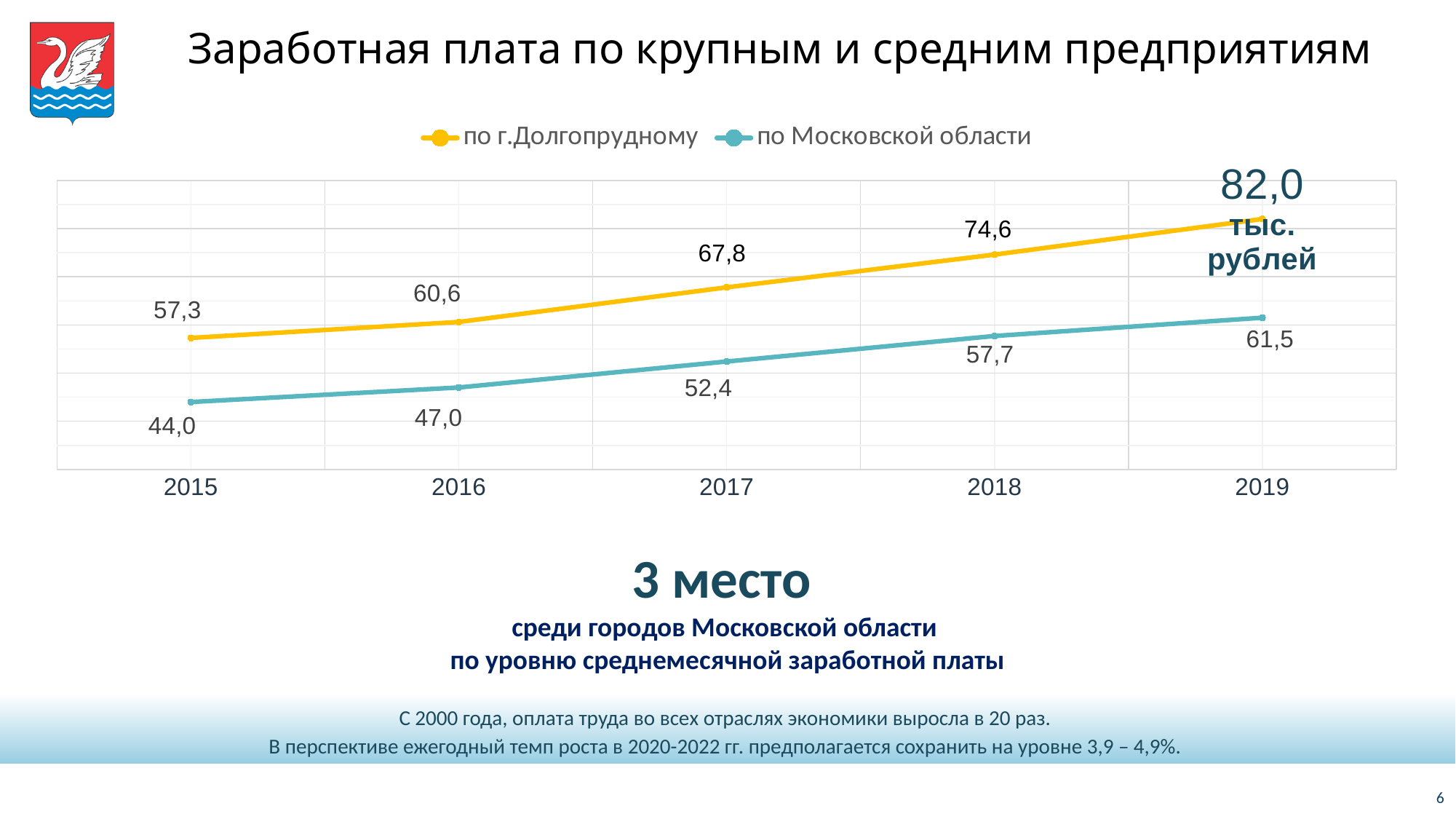
What type of chart is shown on the slide? line chart What is the difference between по г.Долгопрудному and по Московской области in 2019? 20,5 Which series has the larger value in 2016, по г.Долгопрудному or по Московской области? по г.Долгопрудному How many series does the legend list? 2 What is the value for по г.Долгопрудному in 2017? 67,8 What is the value for по Московской области in 2015? 44,0 Do the values for по г.Долгопрудному rise or fall from 2015 to 2019? rise In which year is the value for по г.Долгопрудному highest? 2019 What is the value for по г.Долгопрудному in 2019? 82,0 How many years are plotted on the x axis? 5 In which year is the value for по Московской области lowest? 2015 What is the value for по Московской области in 2018? 57,7